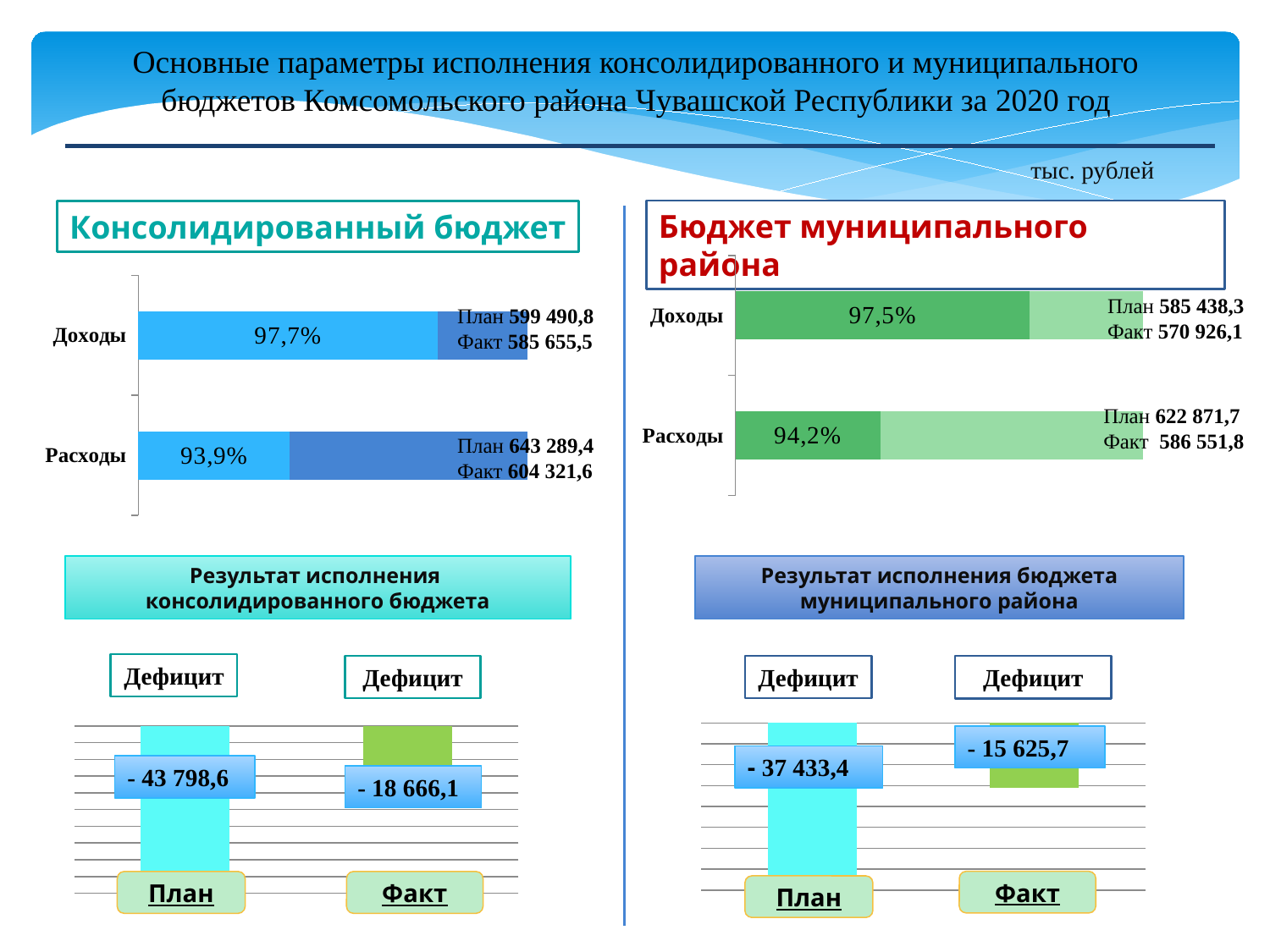
In the 'Консолидированный бюджет' chart, which category has the higher execution percentage, Доходы or Расходы? Доходы In the 'Бюджет муниципального района' chart, what is the execution percentage shown for Расходы? 94,2% In the 'Консолидированный бюджет' chart, what is the difference between the План and Факт values for Доходы? 13 835,3 In the 'Бюджет муниципального района' chart, what is the Факт value for Доходы? 570 926,1 In the 'Бюджет муниципального района' chart, what is the difference between the План and Факт values for Расходы? 36 319,9 In the 'Результат исполнения консолидированного бюджета' chart, what is the Факт deficit value? - 18 666,1 In the 'Результат исполнения бюджета муниципального района' chart, what is the План deficit value? - 37 433,4 What type of chart is used for the 'Консолидированный бюджет' section? Bar chart In the 'Консолидированный бюджет' chart, what is the План value for Расходы? 643 289,4 In the 'Консолидированный бюджет' chart, what is the execution percentage shown for Доходы? 97,7% In the 'Консолидированный бюджет' chart, what is the Факт value for Доходы? 585 655,5 In the 'Бюджет муниципального района' chart, what is the План value for Расходы? 622 871,7